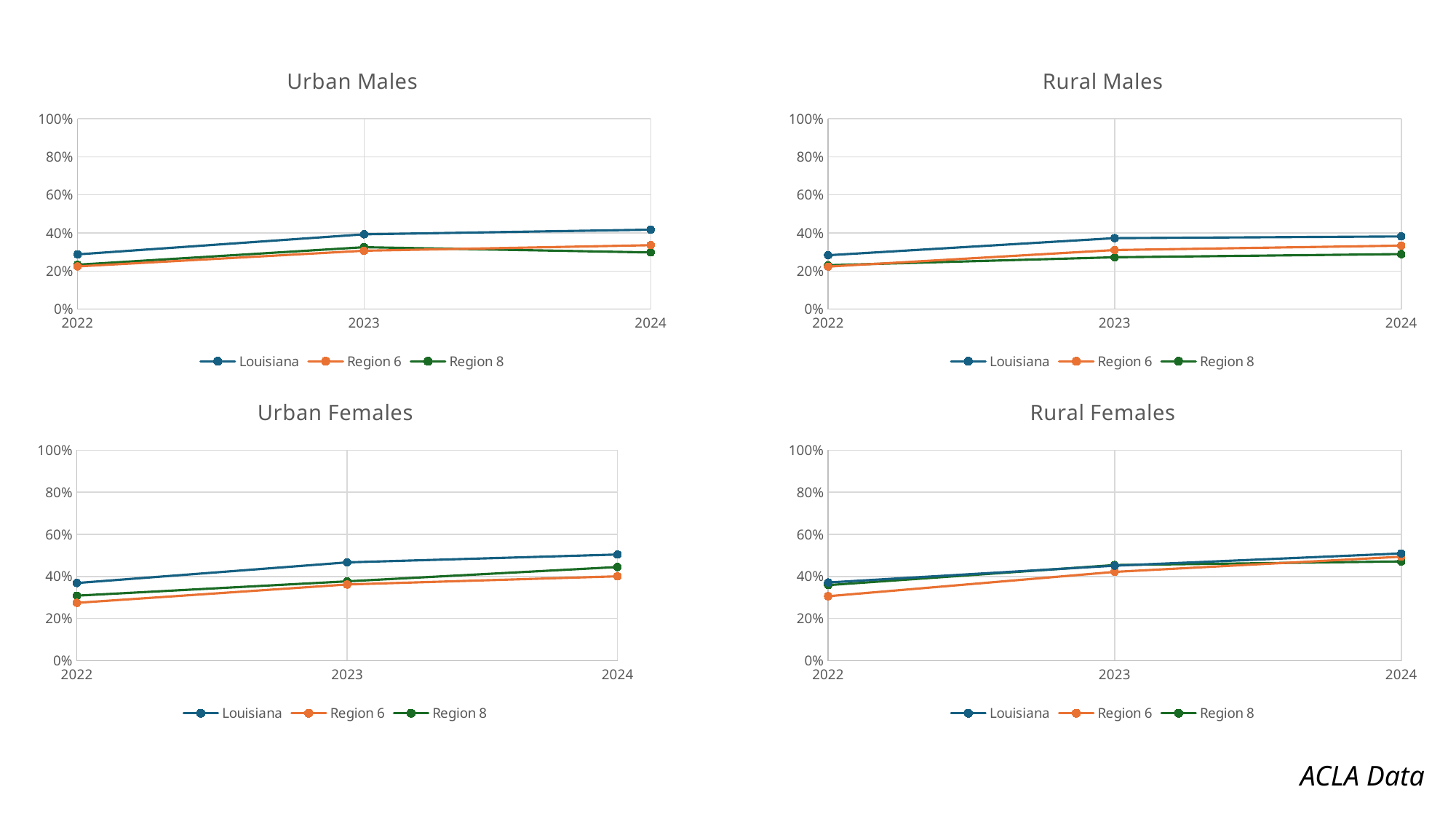
On the Urban Females chart, how many years are plotted along the x axis? 3 On the Urban Males chart, which series has the highest value in 2024? Louisiana On the Urban Females chart, is the Louisiana value for 2024 greater or less than 40%? greater On the Urban Males chart, does the Louisiana line rise or fall from 2022 to 2024? rise On the Urban Males chart, what kind of chart is shown? line chart On the Urban Males chart, does the Region 8 line rise or fall from 2023 to 2024? fall On the Rural Males chart, is the Region 8 value for 2024 greater or less than 40%? less On the Rural Females chart, is the Region 6 value for 2022 greater or less than 40%? less On the Rural Females chart, what are the three series named in the legend? Louisiana, Region 6, Region 8 On the Rural Males chart, which is larger in 2023: Louisiana or Region 8? Louisiana On the Rural Males chart, how many series does the legend list? 3 On the Urban Females chart, which series has the lowest value in 2022? Region 6